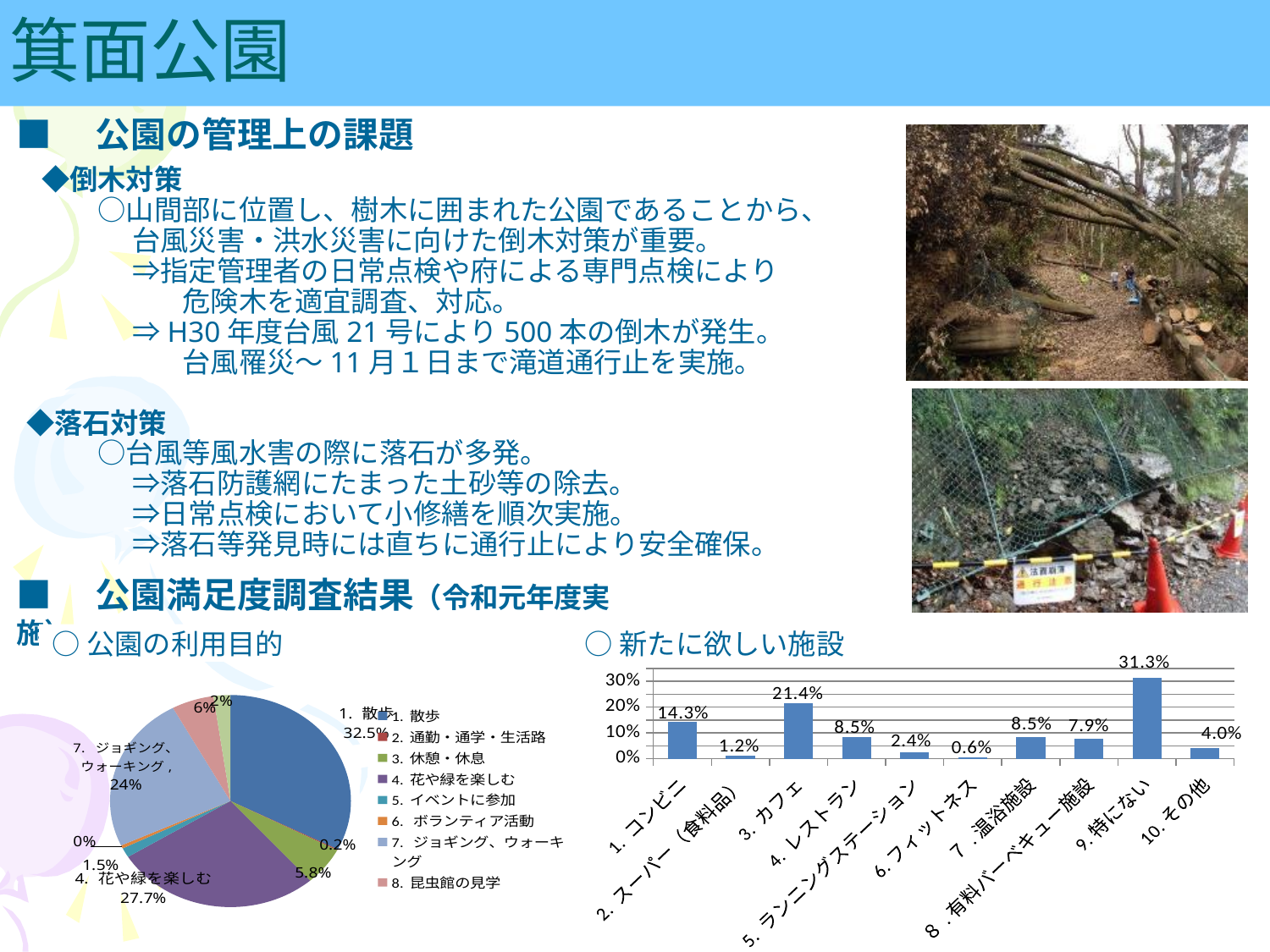
In the bar chart titled 新たに欲しい施設, which category has the highest value? 9. 特にない In the bar chart titled 新たに欲しい施設, which category has the lowest value? 6. フィットネス In the bar chart titled 新たに欲しい施設, which is larger: the value for 8. 有料バーベキュー施設 or 10. その他? 8. 有料バーベキュー施設 In the pie chart titled 公園の利用目的, what is the share for 1. 散歩? 32.5% In the pie chart titled 公園の利用目的, which is larger: the share for 4. 花や緑を楽しむ or 7. ジョギング、ウォーキング? 4. 花や緑を楽しむ In the bar chart titled 新たに欲しい施設, what is the value for 3. カフェ? 21.4% In the bar chart titled 新たに欲しい施設, how many categories are shown on the x axis? 10 In the bar chart titled 新たに欲しい施設, what is the value for 1. コンビニ? 14.3% What kind of chart is the chart titled 新たに欲しい施設? bar chart In the bar chart titled 新たに欲しい施設, what is the difference between the values for 9. 特にない and 3. カフェ? 9.9% How many entries does the legend of the pie chart titled 公園の利用目的 list? 8 In the pie chart titled 公園の利用目的, what is the share for 4. 花や緑を楽しむ? 27.7%